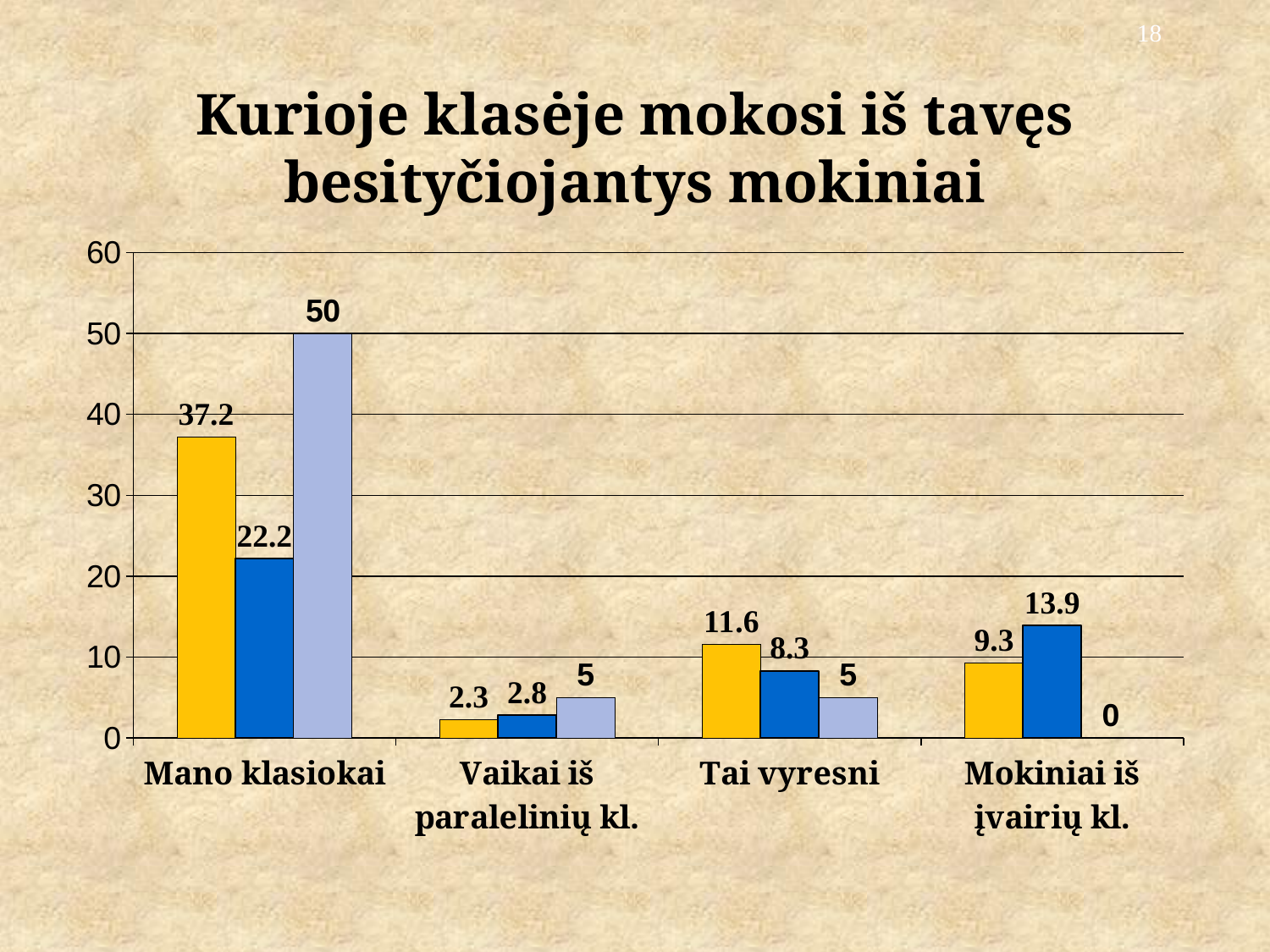
What is the title of the chart on the slide? Kurioje klasėje mokosi iš tavęs besityčiojantys mokiniai How many categories are shown on the x axis? 4 What is the value of the dark blue bar for "Mokiniai iš įvairių kl."? 13.9 Which is larger for "Tai vyresni": the yellow bar or the dark blue bar? the yellow bar What is the value of the light blue bar for "Mokiniai iš įvairių kl."? 0 What is the value of the light blue bar for "Mano klasiokai"? 50 What is the difference between the yellow and dark blue bars for "Mano klasiokai"? 15 Which category has the highest bar in the chart? Mano klasiokai What kind of chart is shown on the slide? bar chart What is the value of the yellow bar for "Mano klasiokai"? 37.2 Which category has the lowest yellow bar? Vaikai iš paralelinių kl. What is the value of the yellow bar for "Tai vyresni"? 11.6